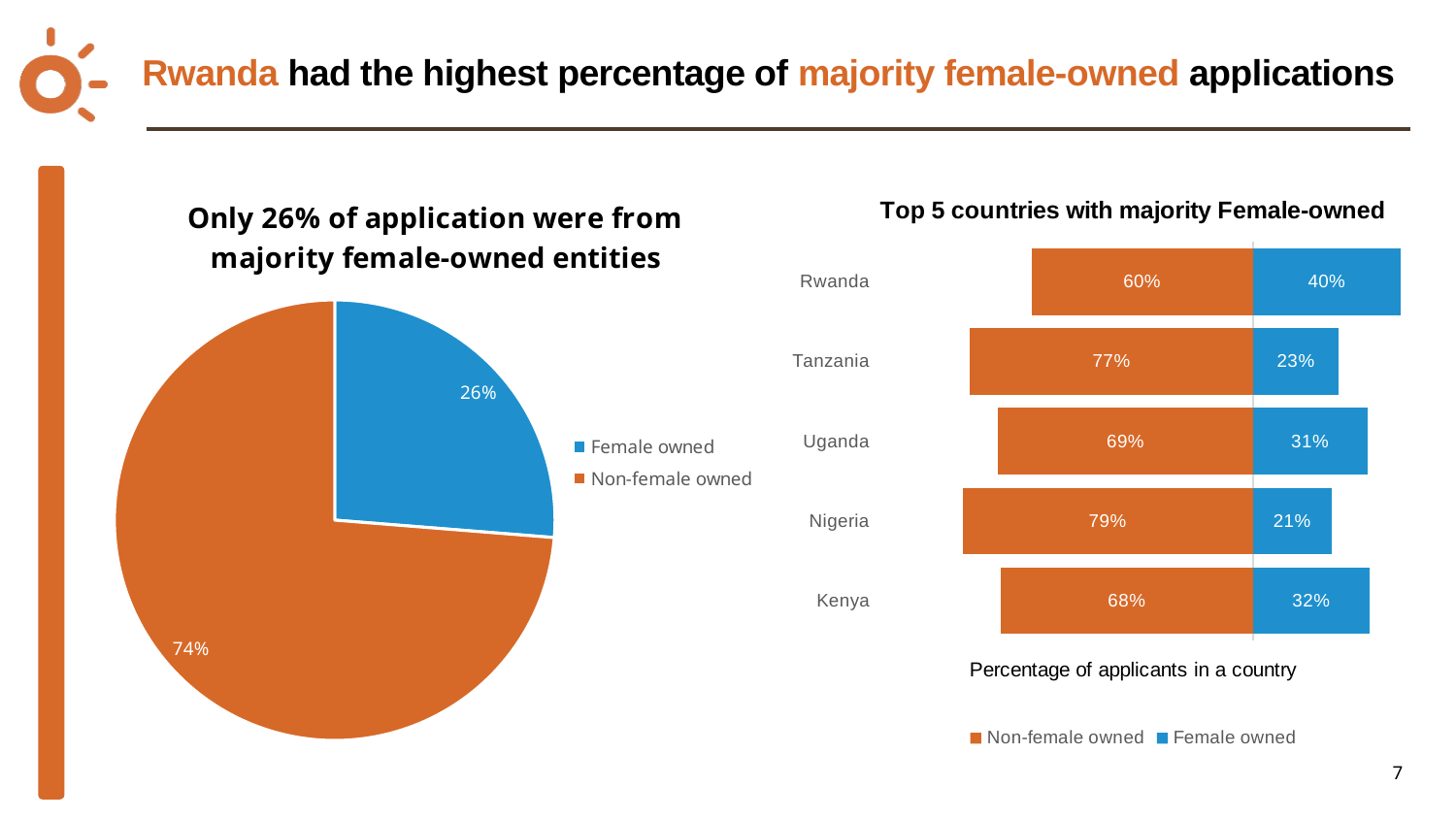
In the chart 'Top 5 countries with majority Female-owned', what is the Non-female owned percentage for Nigeria? 79% How many countries are shown in the chart 'Top 5 countries with majority Female-owned'? 5 In the pie chart on the left, which slice is larger, Female owned or Non-female owned? Non-female owned In the chart 'Top 5 countries with majority Female-owned', which country has the highest Female owned percentage? Rwanda In the chart 'Top 5 countries with majority Female-owned', which country has the lowest Female owned percentage? Nigeria In the pie chart 'Only 26% of application were from majority female-owned entities', what percentage is Non-female owned? 74% What kind of chart is the chart on the left of the slide? Pie chart In the chart 'Top 5 countries with majority Female-owned', what is the difference between the Female owned percentages of Kenya and Tanzania? 9% What kind of chart is 'Top 5 countries with majority Female-owned'? Bar chart In the chart 'Top 5 countries with majority Female-owned', what is the Female owned percentage for Rwanda? 40% How many series does the legend of the chart 'Top 5 countries with majority Female-owned' list? 2 In the pie chart 'Only 26% of application were from majority female-owned entities', what percentage is Female owned? 26%